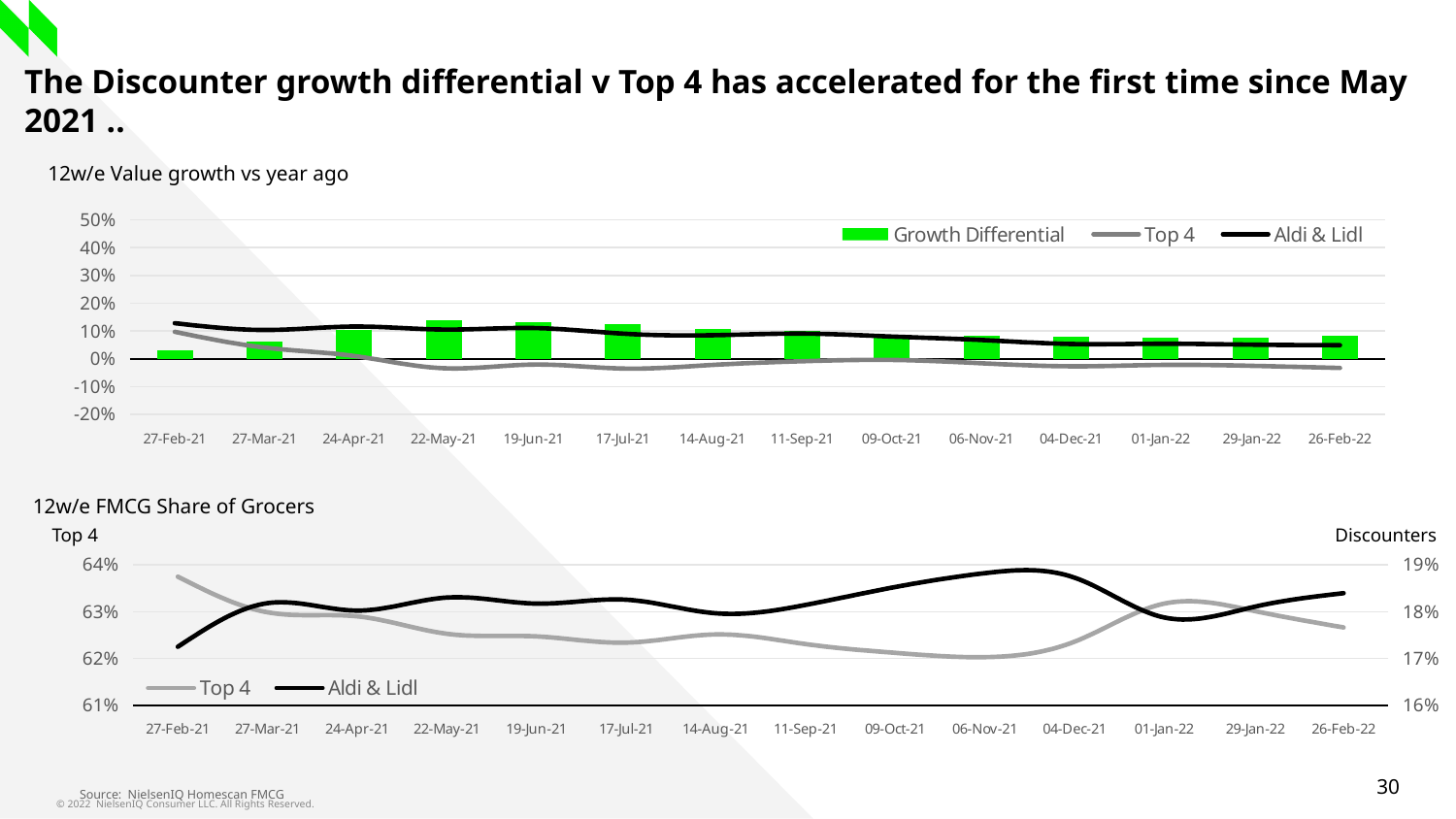
How many series does the legend of the '12w/e Value growth vs year ago' chart list? 3 In the '12w/e Value growth vs year ago' chart, at which date is the Growth Differential bar shortest? 27-Feb-21 How many dates are shown on the x axis of the '12w/e Value growth vs year ago' chart? 14 In the '12w/e Value growth vs year ago' chart, does the Aldi & Lidl line generally rise or fall from 27-Feb-21 to 26-Feb-22? fall In the '12w/e FMCG Share of Grocers' chart, is the Top 4 share at 27-Feb-21 greater or less than 63%? greater In the '12w/e Value growth vs year ago' chart, what colour are the Growth Differential bars? Green In the '12w/e Value growth vs year ago' chart, is the Aldi & Lidl value at 27-Feb-21 greater or less than 10%? greater What kind of chart is the '12w/e Value growth vs year ago' chart? Combined bar and line chart In the '12w/e FMCG Share of Grocers' chart, at which date does the Aldi & Lidl line reach its highest point? 06-Nov-21 In the '12w/e Value growth vs year ago' chart, is the Top 4 value at 26-Feb-22 greater or less than 0%? less How many series does the legend of the '12w/e FMCG Share of Grocers' chart list? 2 In the '12w/e Value growth vs year ago' chart, at which date is the Growth Differential bar tallest? 22-May-21